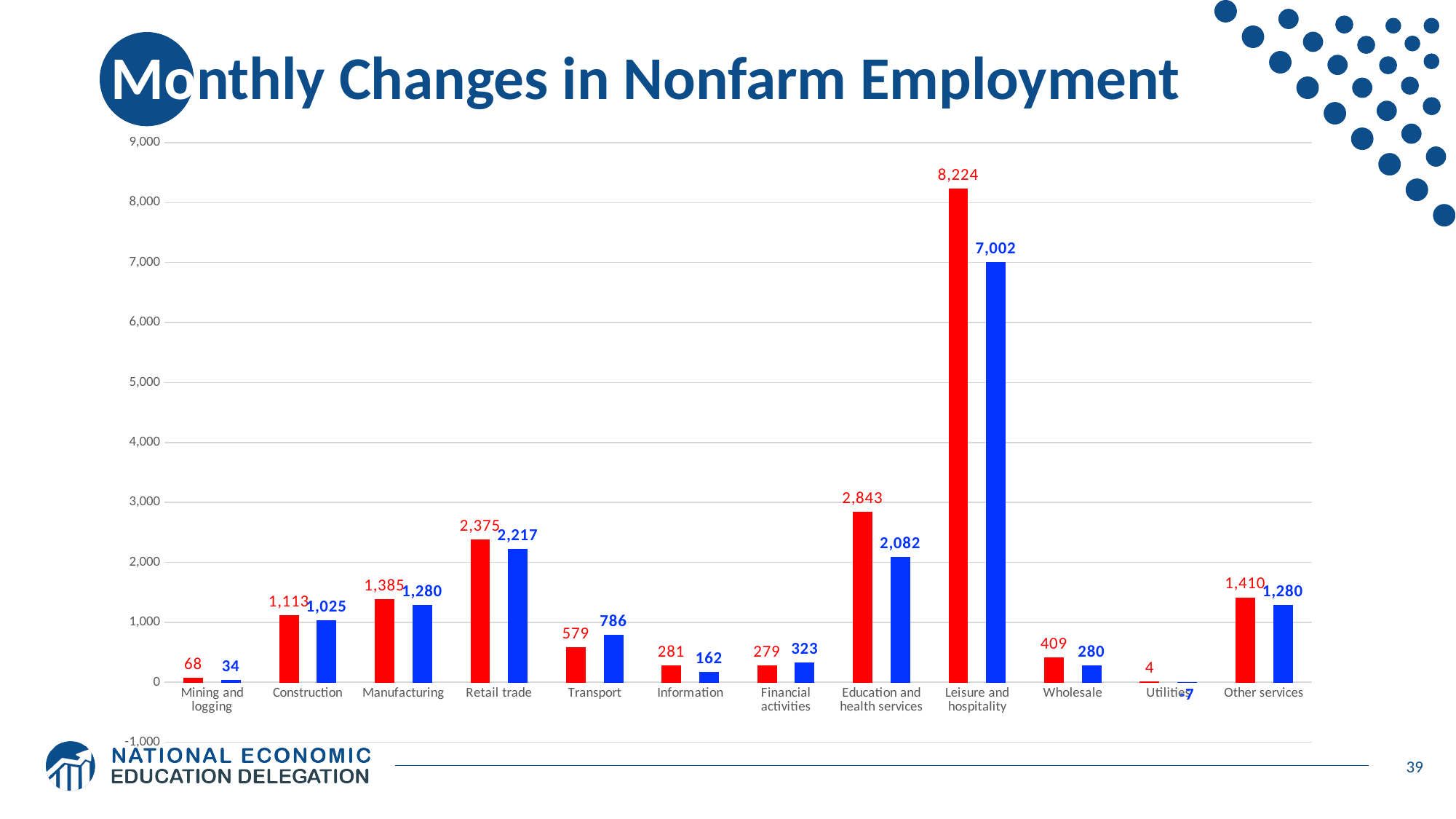
What is the difference between the red and blue bars for Leisure and hospitality? 1,222 What is the difference between the red and blue bars for Retail trade? 158 How many categories are shown on the x axis? 12 What kind of chart is shown on the slide? bar chart Which category has the highest red bar? Leisure and hospitality Is the red bar for Education and health services greater or less than 2,000? greater Which category has the lowest red bar? Utilities What is the value of the blue bar for Education and health services? 2,082 What is the value of the red bar for Wholesale? 409 What is the value of the red bar for Leisure and hospitality? 8,224 For Financial activities, which is larger, the red bar or the blue bar? the blue bar What is the value of the blue bar for Transport? 786